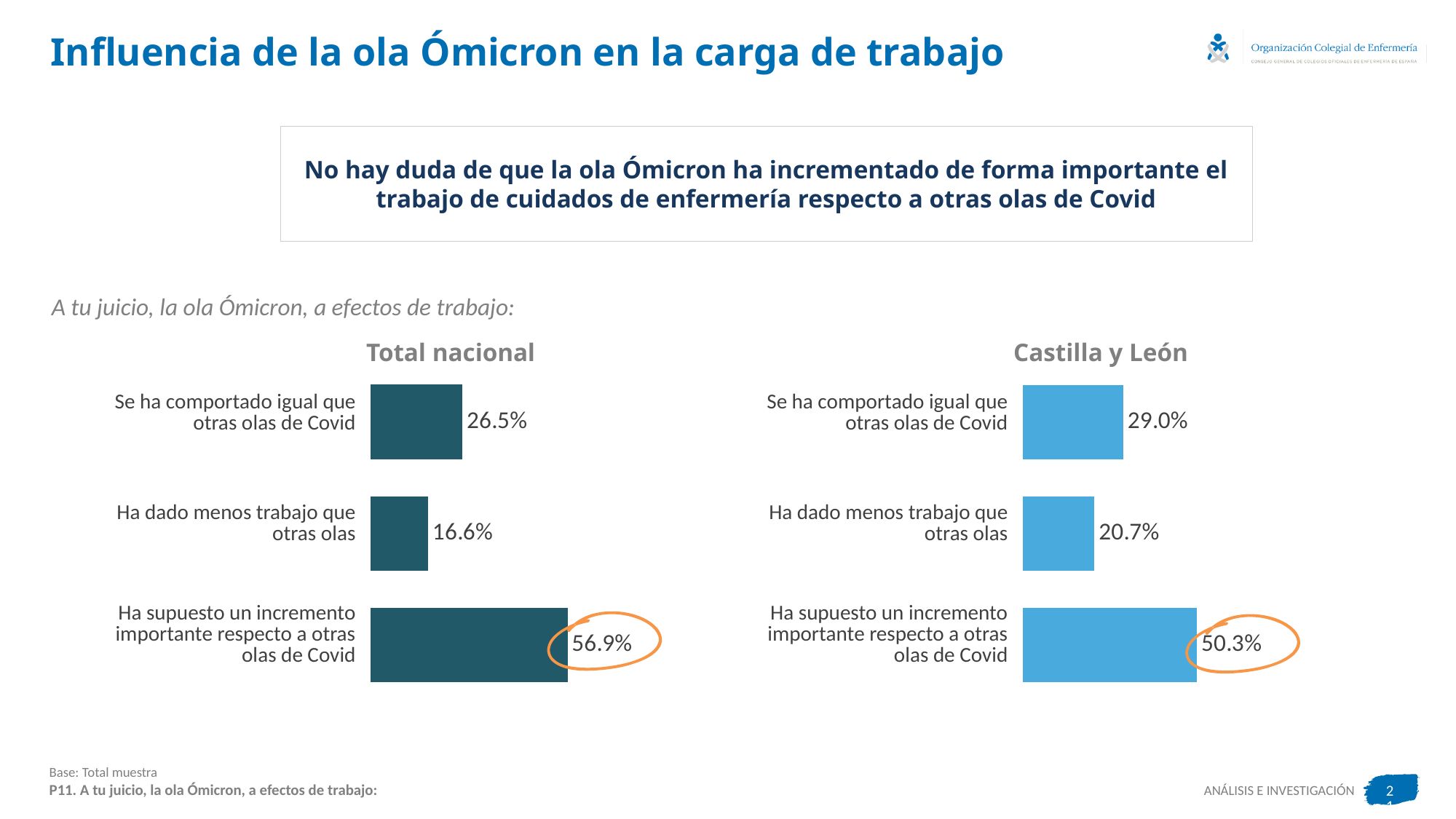
In the 'Castilla y León' chart, what is the value for 'Se ha comportado igual que otras olas de Covid'? 29.0% In the 'Total nacional' chart, what is the value for 'Ha supuesto un incremento importante respecto a otras olas de Covid'? 56.9% Which is larger: 'Se ha comportado igual que otras olas de Covid' in the 'Total nacional' chart or in the 'Castilla y León' chart? Castilla y León In the 'Total nacional' chart, which category has the highest value? Ha supuesto un incremento importante respecto a otras olas de Covid What is the difference between the 'Ha supuesto un incremento importante respecto a otras olas de Covid' value in the 'Total nacional' chart and the same category in the 'Castilla y León' chart? 6.6% In the 'Castilla y León' chart, what is the value for 'Ha dado menos trabajo que otras olas'? 20.7% How many categories does the 'Castilla y León' chart show? 3 What is the title of the chart on the right side of the slide? Castilla y León In the 'Total nacional' chart, what is the value for 'Ha dado menos trabajo que otras olas'? 16.6% In the 'Castilla y León' chart, which category has the lowest value? Ha dado menos trabajo que otras olas What kind of chart is the 'Total nacional' chart? Bar chart In the 'Total nacional' chart, what is the difference between 'Se ha comportado igual que otras olas de Covid' and 'Ha dado menos trabajo que otras olas'? 9.9%